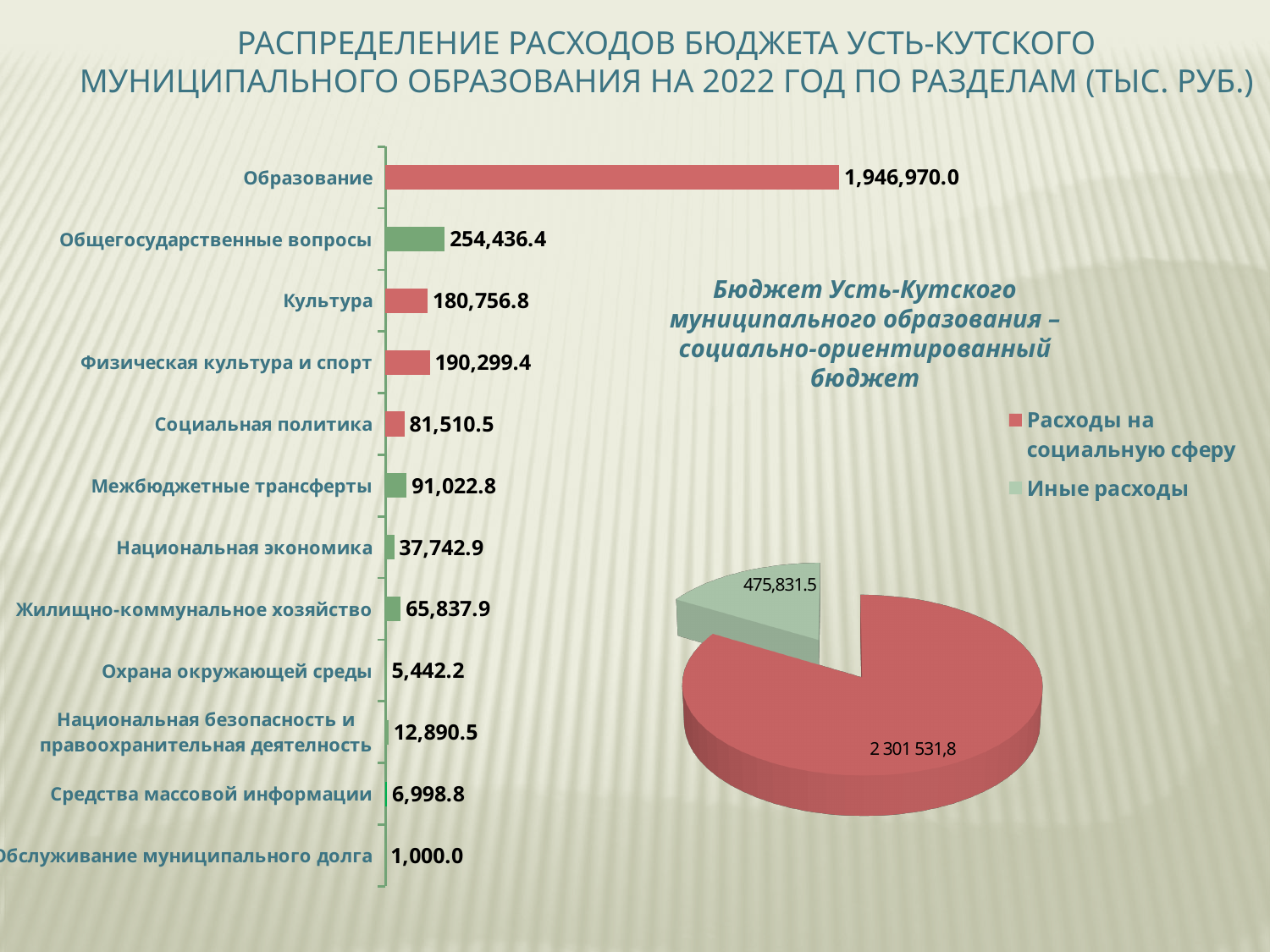
What kind of chart is on the left side of the slide? Bar chart In the bar chart on the left, what is the difference between Физическая культура и спорт and Культура? 9,542.6 In the pie chart on the right, what is the value for Иные расходы? 475,831.5 How many entries does the legend of the pie chart on the right list? 2 In the bar chart on the left, which is larger: Межбюджетные трансферты or Социальная политика? Межбюджетные трансферты In the bar chart on the left, what is the value for Национальная безопасность и правоохранительная деятельность? 12,890.5 In the pie chart on the right, what is the value for Расходы на социальную сферу? 2 301 531,8 In the bar chart on the left, what is the value for Жилищно-коммунальное хозяйство? 65,837.9 In the bar chart on the left, which category has the highest value? Образование In the bar chart on the left, what is the value for Образование? 1,946,970.0 How many categories are shown in the bar chart on the left? 12 In the bar chart on the left, which category has the lowest value? Обслуживание муниципального долга